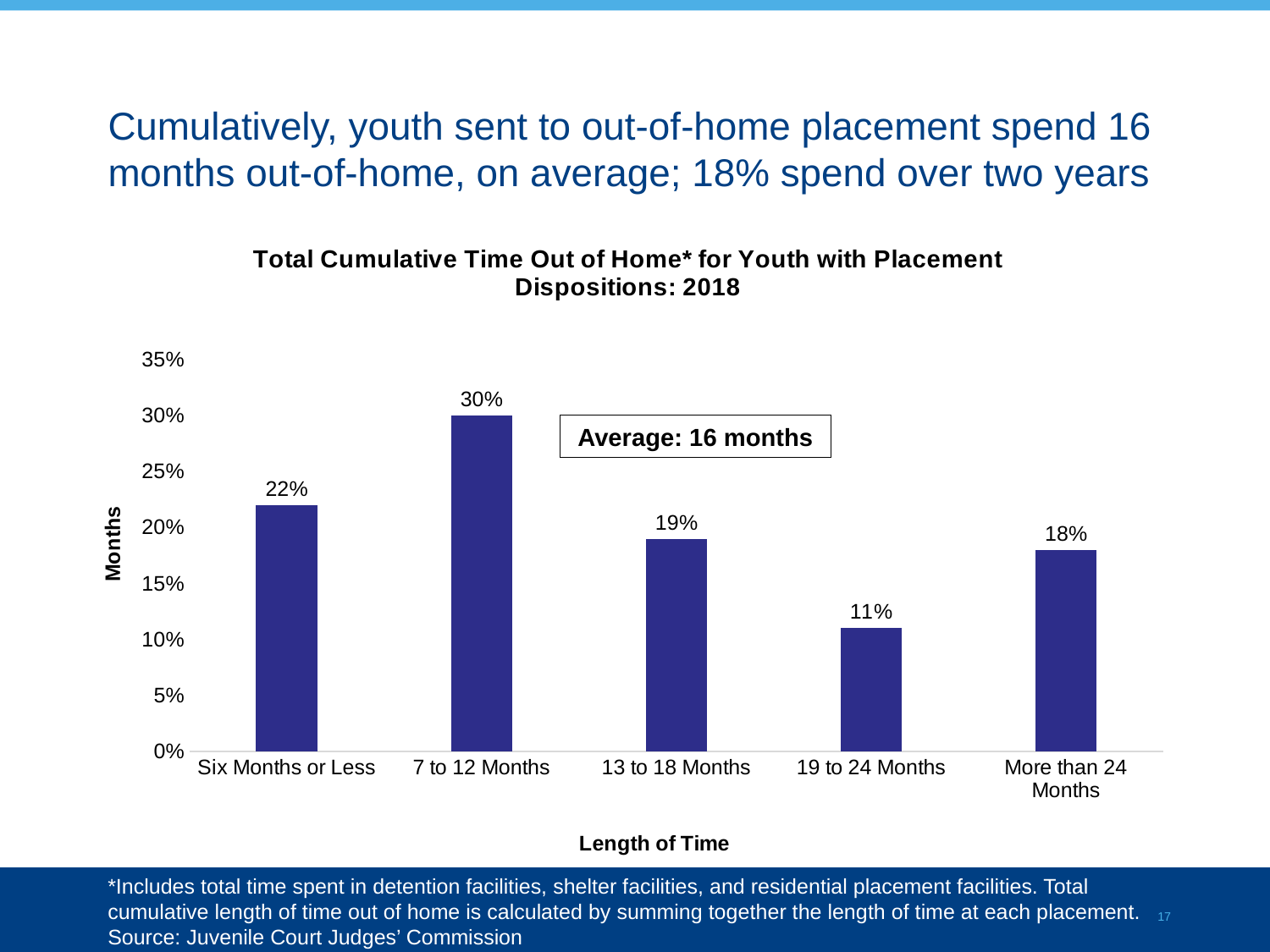
What average is stated in the box on the chart? Average: 16 months How many length-of-time categories are shown on the x axis? 5 Which length-of-time category has the lowest percentage? 19 to 24 Months What kind of chart is shown on the slide? Bar chart What is the difference between the percentages for '7 to 12 Months' and '19 to 24 Months'? 19% What is the difference between the percentages for 'Six Months or Less' and 'More than 24 Months'? 4% What is the value for the 'Six Months or Less' category? 22% Which length-of-time category has the highest percentage? 7 to 12 Months Is the value for '19 to 24 Months' greater or less than 15%? less Which is larger: the value for '13 to 18 Months' or the value for 'More than 24 Months'? 13 to 18 Months What percentage of youth spent 7 to 12 months out of home? 30% What percentage of youth spent 19 to 24 months out of home? 11%